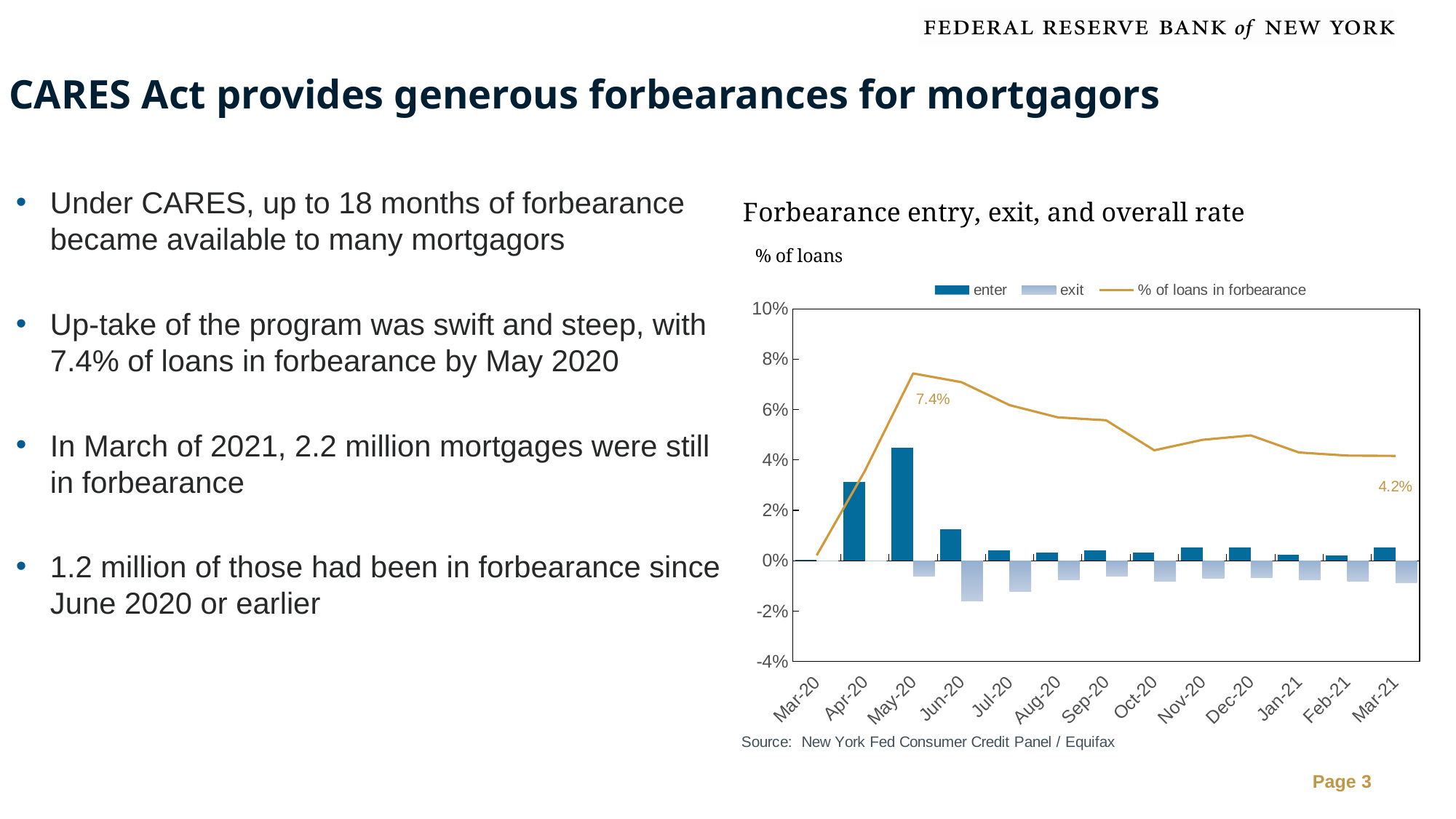
Does the % of loans in forbearance rise or fall from May-20 to Mar-21? fall How many months are shown on the x axis? 13 In which month does the % of loans in forbearance line reach its peak? May-20 Which month has the tallest 'enter' bar? May-20 What is the % of loans in forbearance in May-20? 7.4% How many series does the legend list? 3 What is the title of the chart? Forbearance entry, exit, and overall rate What is the % of loans in forbearance in Mar-21? 4.2% Is the 'enter' value for Apr-20 greater or less than 2%? greater What kind of chart is this? Combination bar and line chart Which month has the largest 'exit' bar (most negative)? Jun-20 By how much did the % of loans in forbearance fall from May-20 to Mar-21? 3.2%